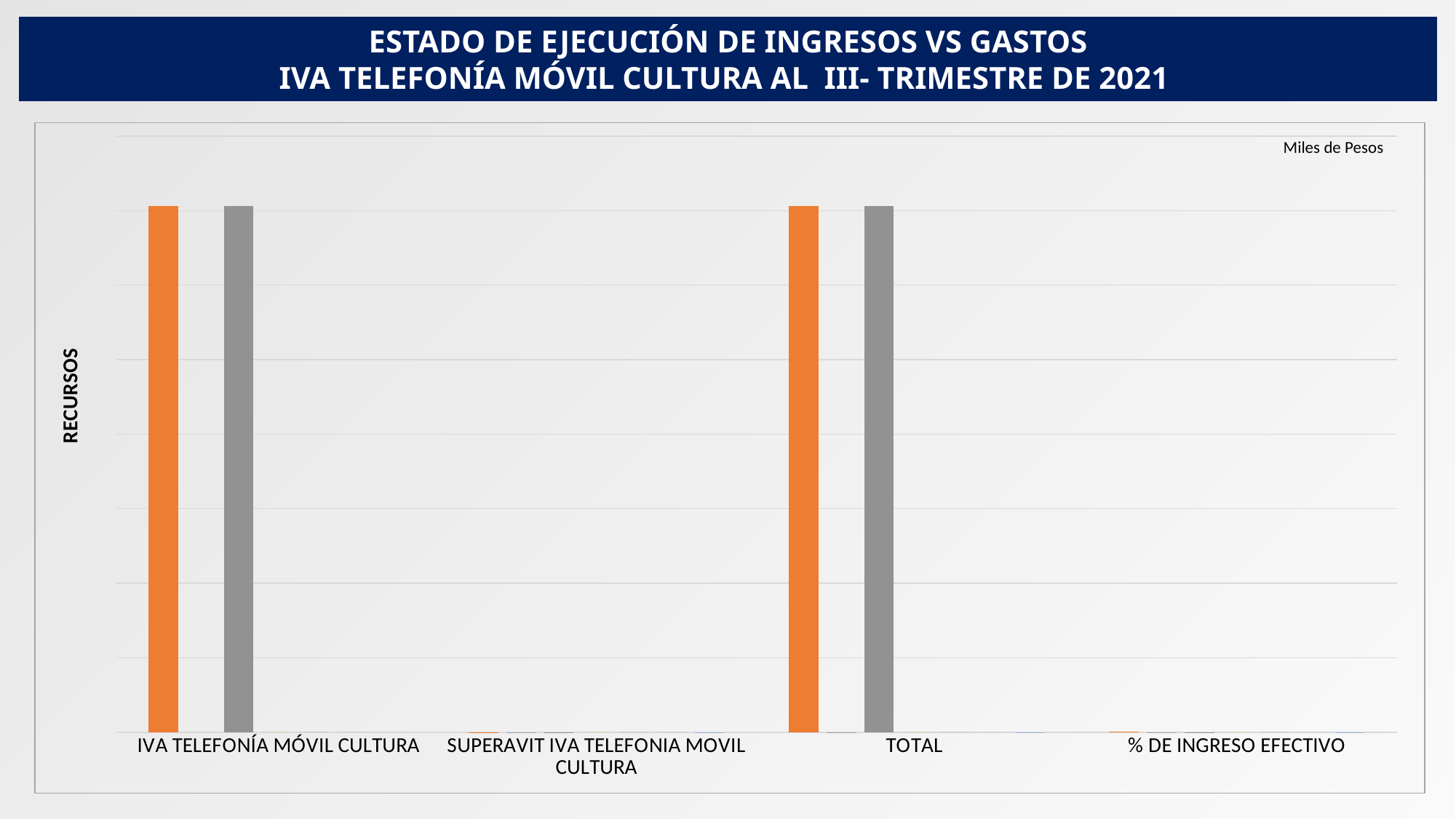
Which category has larger bars: IVA TELEFONÍA MÓVIL CULTURA or SUPERAVIT IVA TELEFONIA MOVIL CULTURA? IVA TELEFONÍA MÓVIL CULTURA What is the title of the chart? ESTADO DE EJECUCIÓN DE INGRESOS VS GASTOS IVA TELEFONÍA MÓVIL CULTURA AL III- TRIMESTRE DE 2021 What is the label on the vertical axis of the chart? RECURSOS How many categories are shown on the x axis of the chart? 4 What kind of chart is shown on the slide? bar chart Which category has larger bars: % DE INGRESO EFECTIVO or IVA TELEFONÍA MÓVIL CULTURA? IVA TELEFONÍA MÓVIL CULTURA Which category has larger bars: TOTAL or % DE INGRESO EFECTIVO? TOTAL